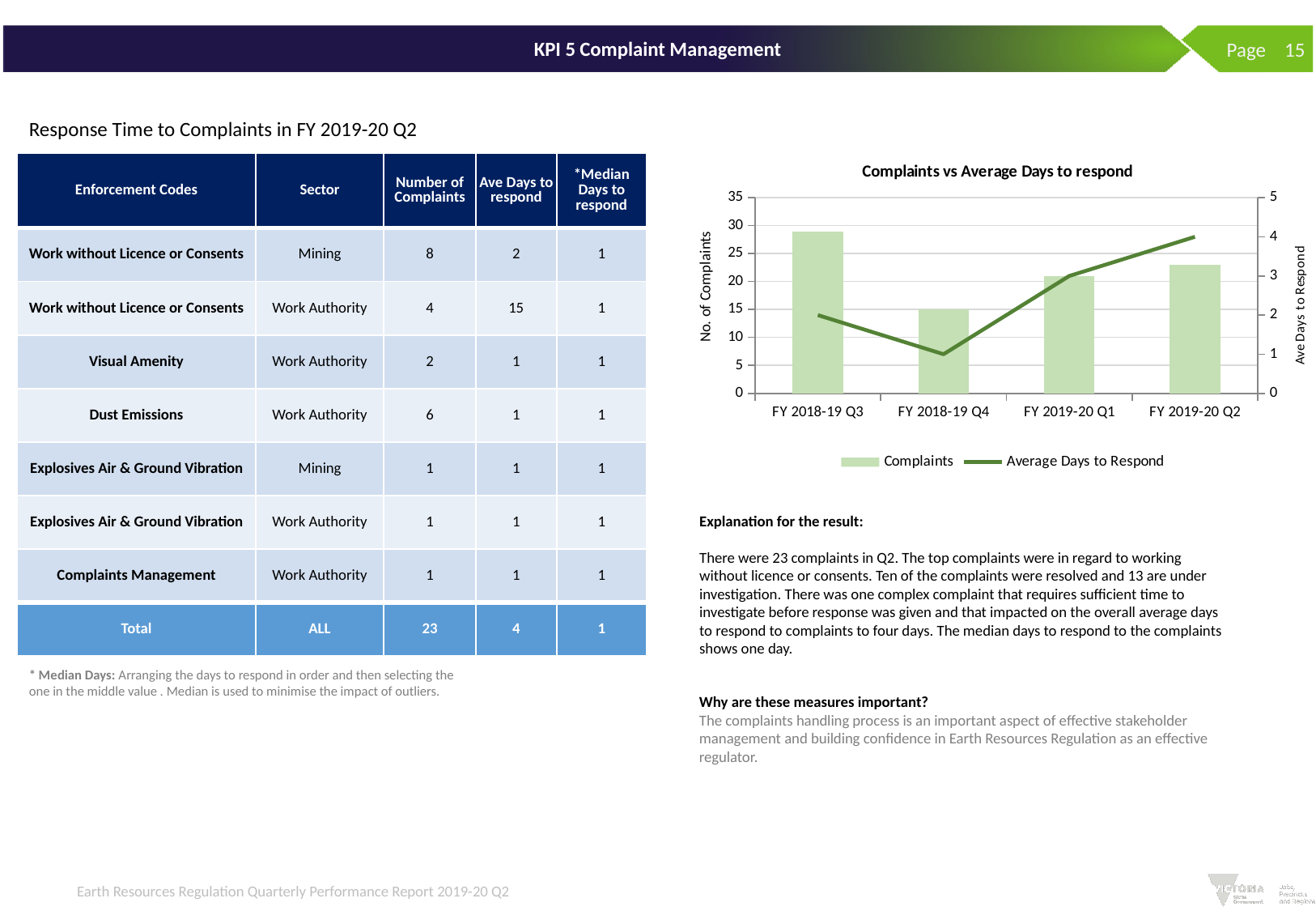
In the 'Complaints vs Average Days to respond' chart, does the average days to respond rise or fall from FY 2018-19 Q4 to FY 2019-20 Q2? Rise In the 'Complaints vs Average Days to respond' chart, how many complaints were there in FY 2018-19 Q4? 15 In the 'Complaints vs Average Days to respond' chart, which quarter has the highest number of complaints? FY 2018-19 Q3 In the 'Complaints vs Average Days to respond' chart, which quarter has more complaints, FY 2018-19 Q3 or FY 2019-20 Q2? FY 2018-19 Q3 In the 'Complaints vs Average Days to respond' chart, which quarter has the lowest number of complaints? FY 2018-19 Q4 In the 'Complaints vs Average Days to respond' chart, what is the average days to respond for FY 2019-20 Q2? 4 How many quarters are shown on the x axis of the 'Complaints vs Average Days to respond' chart? 4 In the 'Complaints vs Average Days to respond' chart, which quarter has the highest average days to respond? FY 2019-20 Q2 What kind of chart is 'Complaints vs Average Days to respond'? A combined bar and line chart In the 'Complaints vs Average Days to respond' chart, what is the average days to respond for FY 2018-19 Q4? 1 How many series does the legend of the 'Complaints vs Average Days to respond' chart list? 2 In the 'Complaints vs Average Days to respond' chart, is the number of complaints for FY 2018-19 Q3 greater or less than 25? greater